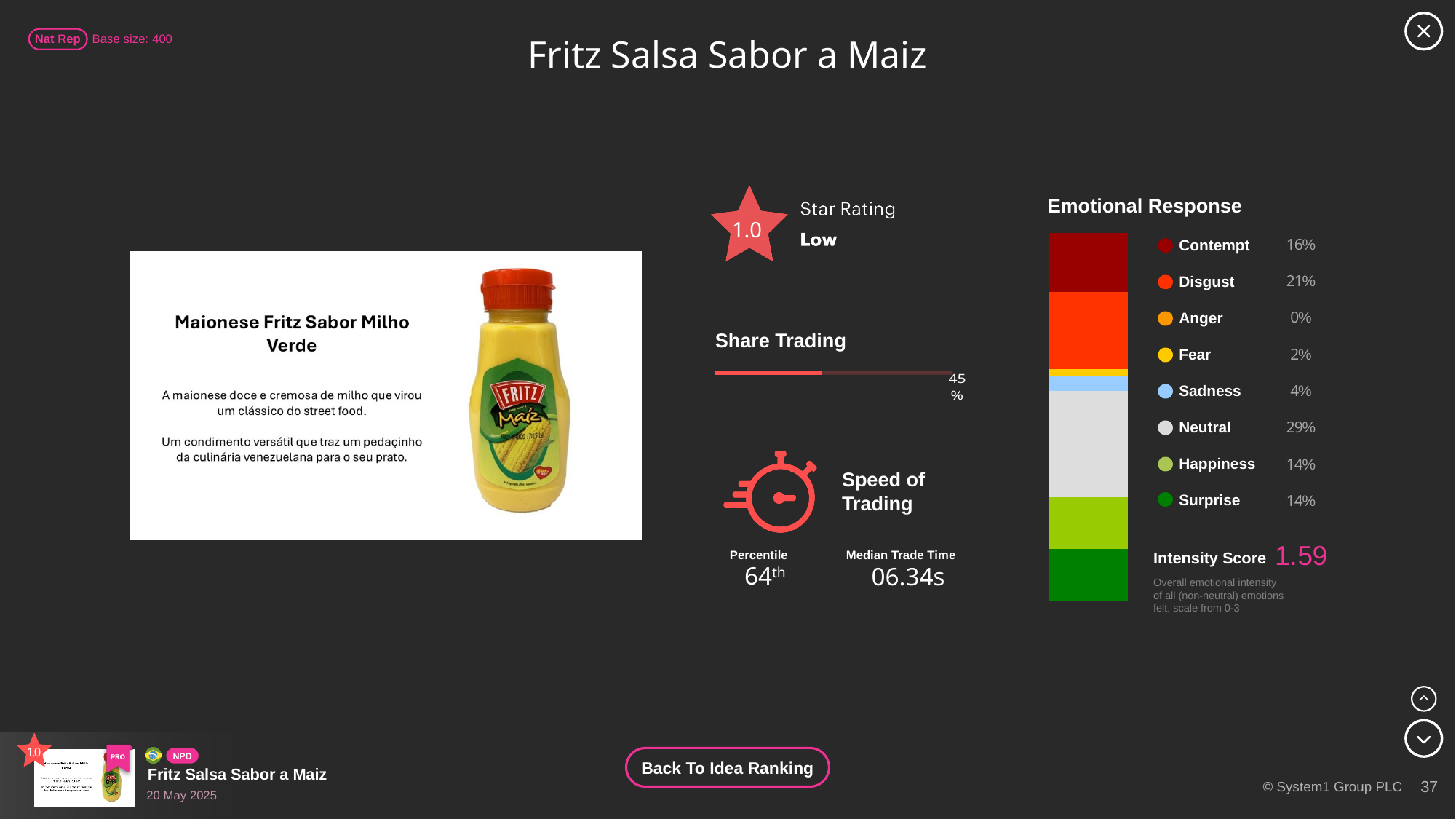
In the Emotional Response chart, what colour represents Neutral? Light grey What is the total of all the percentages in the Emotional Response chart? 100% How many emotions are listed in the Emotional Response chart legend? 8 In the Emotional Response chart, what percentage is shown for Neutral? 29% In the Emotional Response chart, which emotion has the highest percentage? Neutral In the Emotional Response chart, which emotion has the lowest percentage? Anger In the Emotional Response chart, what is the difference between the Disgust and Contempt percentages? 5% In the Emotional Response chart, which is larger, Sadness or Fear? Sadness In the Emotional Response chart, what percentage is shown for Happiness? 14% In the Emotional Response chart, what percentage is shown for Disgust? 21% What value is shown on the Share Trading bar? 45% What kind of chart is the Emotional Response chart? Stacked bar chart